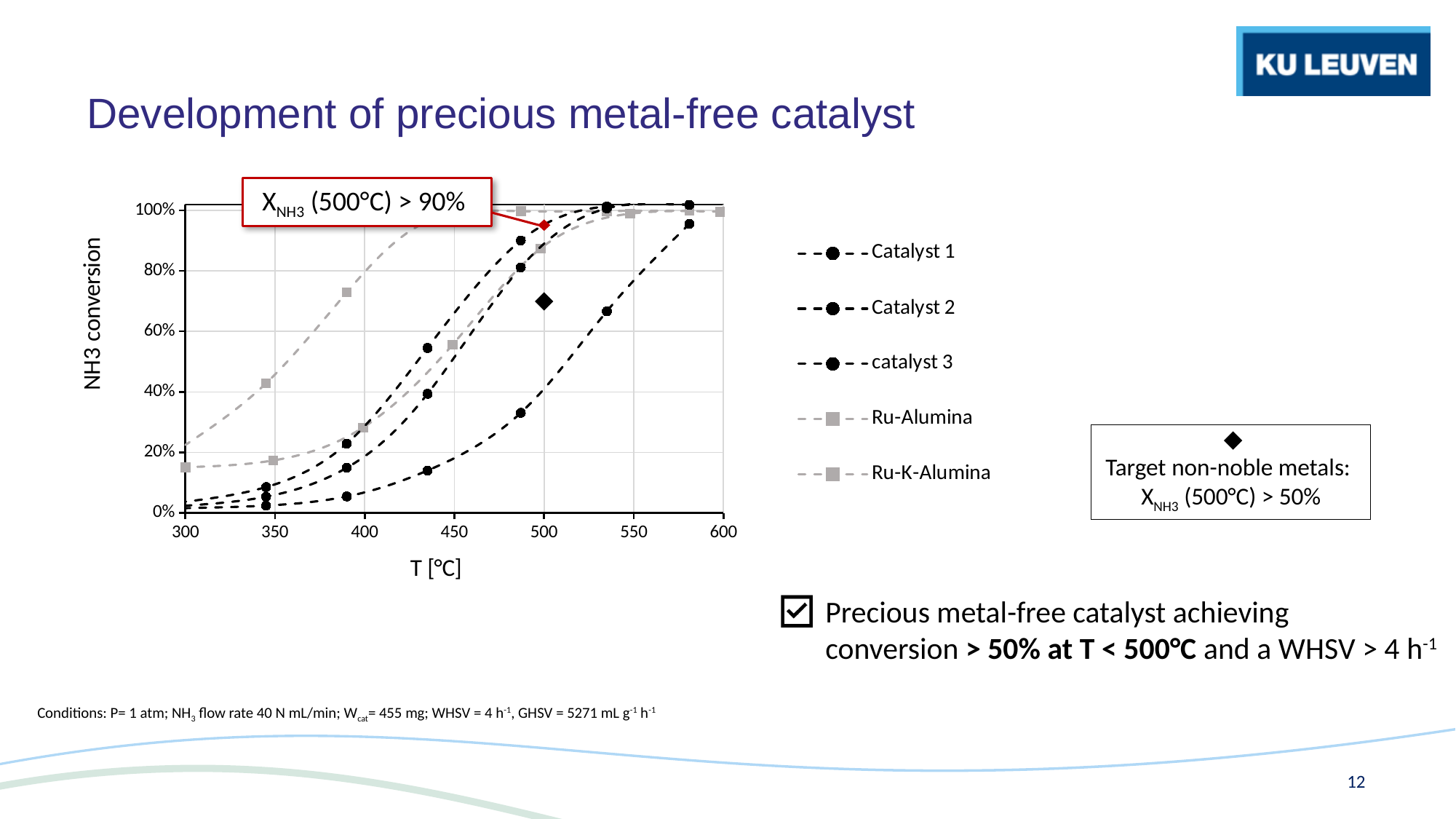
Is the value of the target non-noble metals marker (black diamond at 500°C) greater or less than 60%? greater What is the label of the x axis of the chart? T [°C] What is the label of the y axis of the chart? NH3 conversion At 600°C, is the lowest series value greater or less than 80%? greater How many series does the chart legend list? 5 At 300°C, is the highest series value greater or less than 40%? less Do the NH3 conversion values rise or fall as temperature increases along the x axis? rise What is the highest value shown on the y axis of the chart? 100% How many temperature tick marks are shown on the x axis? 7 What kind of chart is shown on the slide? line chart